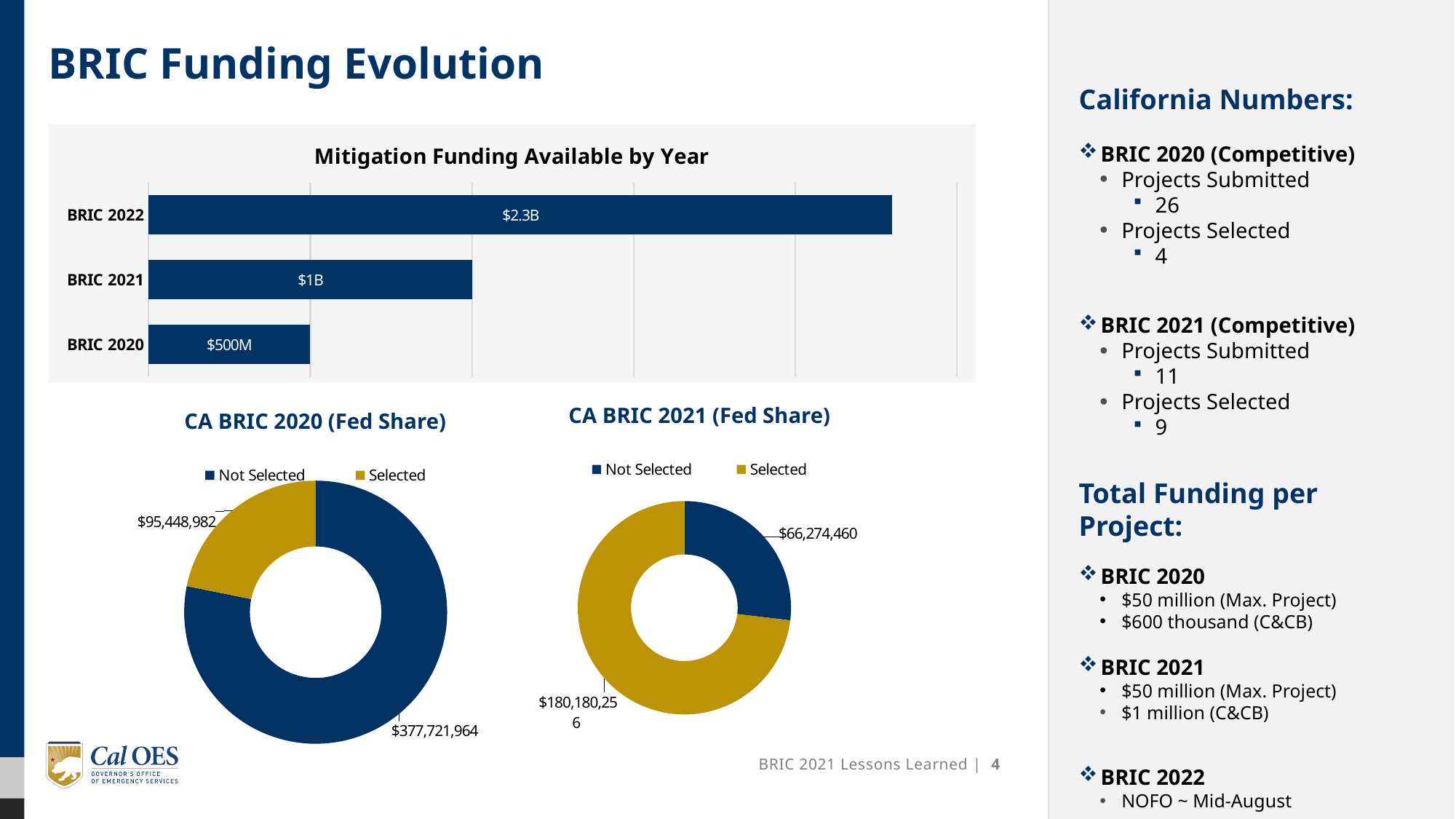
In the 'Mitigation Funding Available by Year' chart, which year has the highest funding? BRIC 2022 In the 'CA BRIC 2021 (Fed Share)' chart, which is larger, Selected or Not Selected? Selected What kind of chart is 'Mitigation Funding Available by Year'? Bar chart How many series does the legend of the 'CA BRIC 2020 (Fed Share)' chart list? 2 In the 'Mitigation Funding Available by Year' chart, what is the difference between BRIC 2022 and BRIC 2021? $1.3B How many categories are shown in the 'Mitigation Funding Available by Year' chart? 3 In the 'CA BRIC 2021 (Fed Share)' chart, what is the difference between Selected and Not Selected? $113,905,796 In the 'Mitigation Funding Available by Year' chart, what is the value for BRIC 2022? $2.3B In the 'CA BRIC 2020 (Fed Share)' chart, what is the value for Not Selected? $377,721,964 In the 'CA BRIC 2021 (Fed Share)' chart, what is the value for Selected? $180,180,256 In the 'Mitigation Funding Available by Year' chart, what is the value for BRIC 2020? $500M In the 'CA BRIC 2020 (Fed Share)' chart, what is the value for Selected? $95,448,982